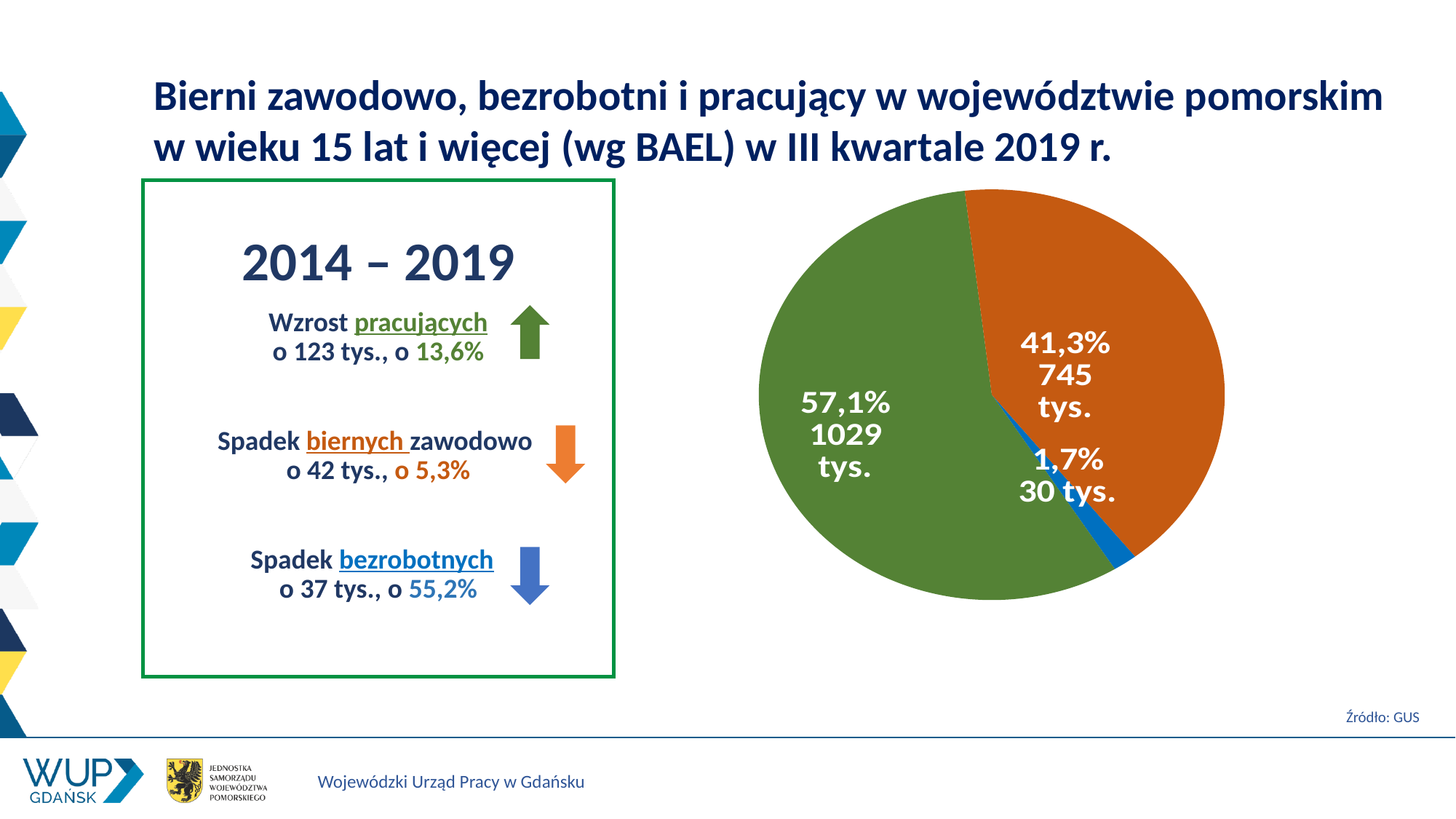
What kind of chart is shown on the slide? pie chart What percentage is printed on the orange slice of the pie chart? 41,3% What value in thousands is printed on the green slice of the pie chart? 1029 tys. How many slices does the pie chart have? 3 Which slice of the pie chart is the smallest? the blue slice (1,7%, 30 tys.) What is the total in thousands of all three slices of the pie chart? 1804 tys. Which is larger in the pie chart, the orange slice or the blue slice? the orange slice Which slice of the pie chart is the largest? the green slice (57,1%, 1029 tys.) What share of the pie does the green slice represent? 57,1% What source is cited for the data on the slide? GUS What value in thousands is printed on the blue slice of the pie chart? 30 tys. What is the difference in thousands between the green slice and the orange slice of the pie chart? 284 tys.